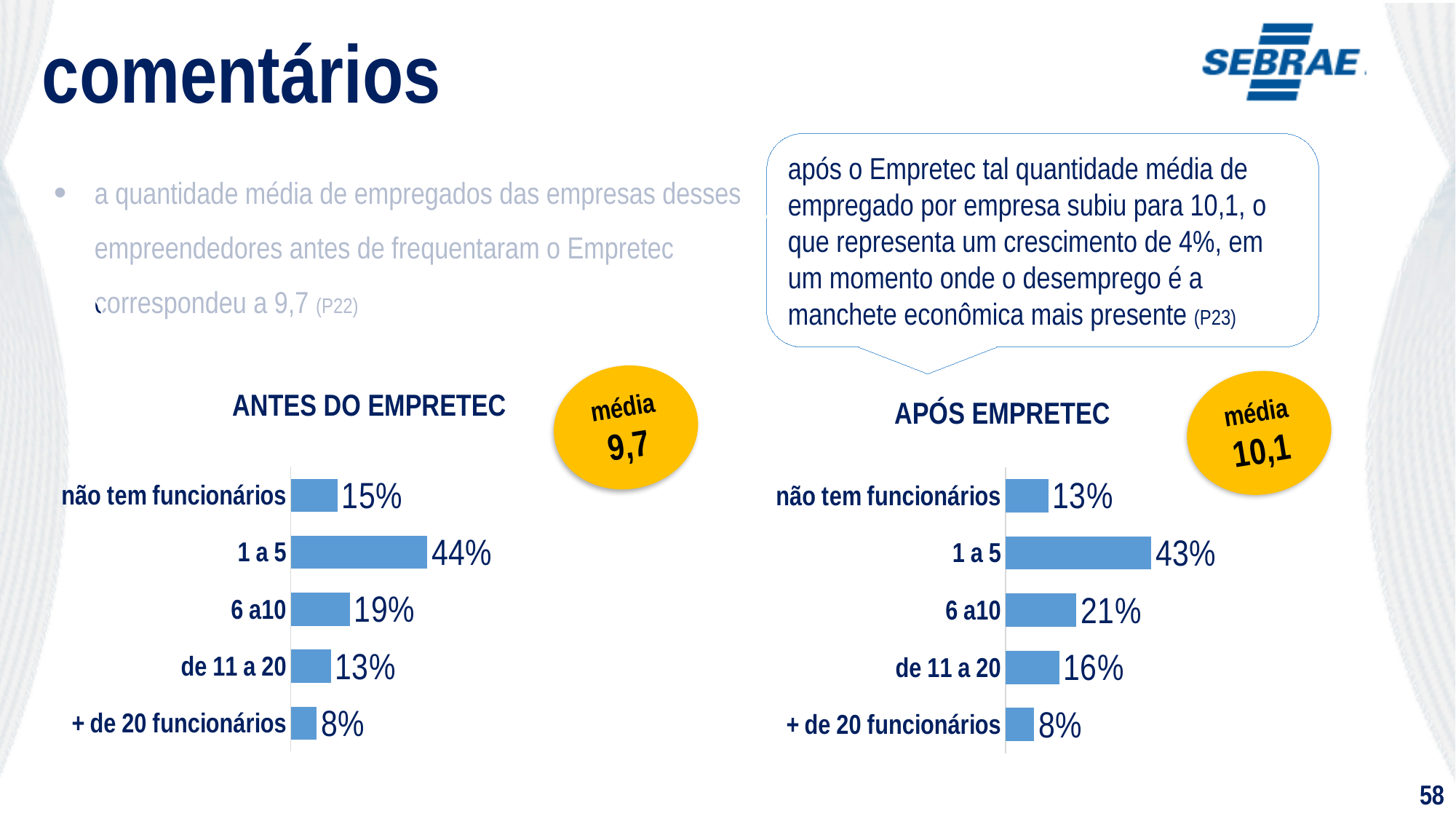
What kind of chart is the 'APÓS EMPRETEC' chart? Bar chart What average ('média') is shown in the yellow circle next to the 'ANTES DO EMPRETEC' chart? 9,7 In the 'ANTES DO EMPRETEC' chart, what is the value for '1 a 5'? 44% In the 'ANTES DO EMPRETEC' chart, what is the difference between the values for '1 a 5' and '6 a10'? 25% How many categories does the 'ANTES DO EMPRETEC' chart show? 5 In the 'APÓS EMPRETEC' chart, what is the value for 'não tem funcionários'? 13% In the 'ANTES DO EMPRETEC' chart, which category has the highest value? 1 a 5 What average ('média') is shown in the yellow circle next to the 'APÓS EMPRETEC' chart? 10,1 In the 'APÓS EMPRETEC' chart, which category has the lowest value? + de 20 funcionários In the 'APÓS EMPRETEC' chart, what is the value for '6 a10'? 21% Which is larger: the value for 'de 11 a 20' in the 'ANTES DO EMPRETEC' chart or in the 'APÓS EMPRETEC' chart? APÓS EMPRETEC In the 'APÓS EMPRETEC' chart, what is the difference between the values for 'de 11 a 20' and '+ de 20 funcionários'? 8%